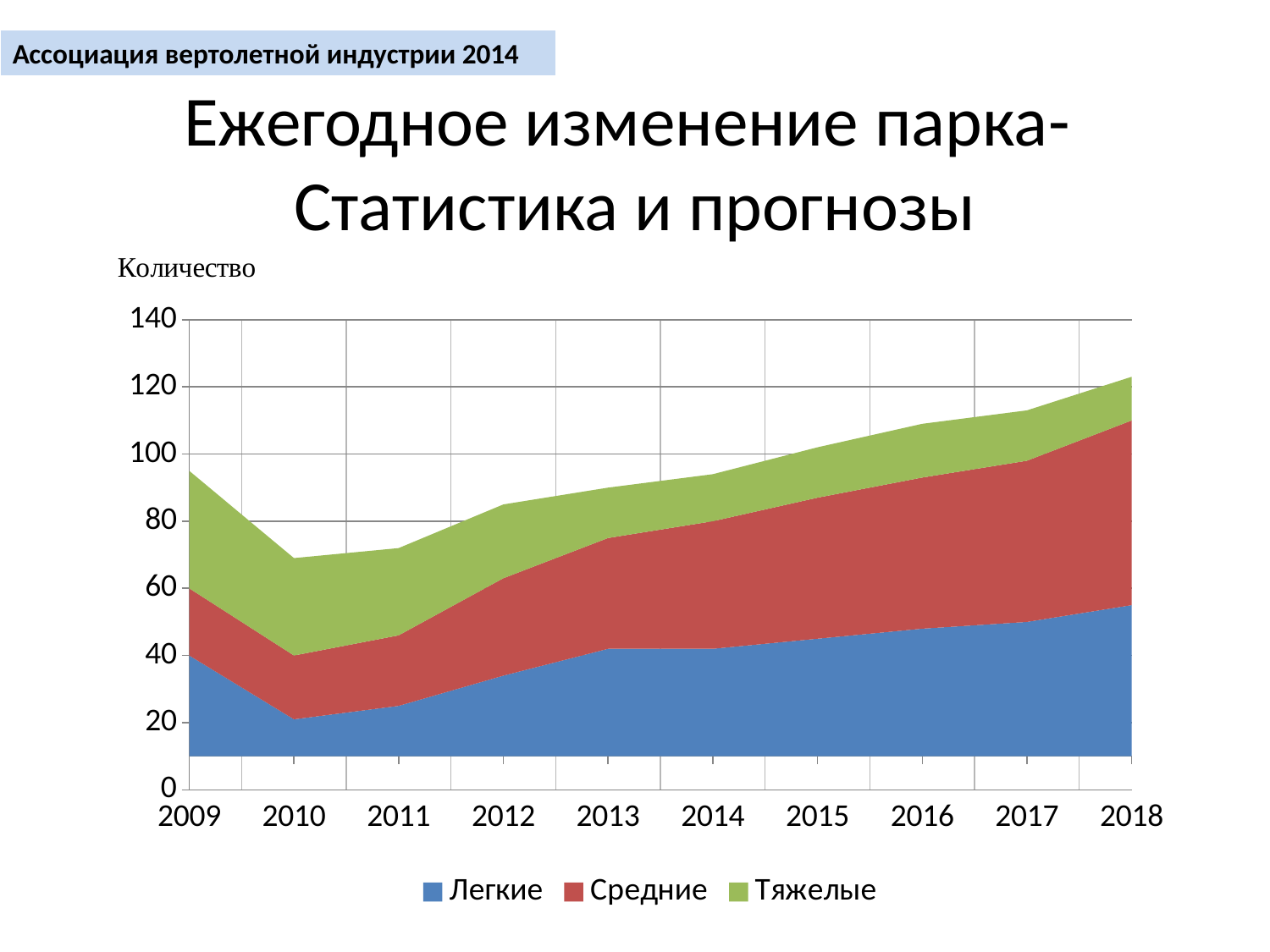
Is the top of the Легкие area in 2018 greater or less than 40? greater In which year is the total stacked value the highest? 2018 Is the total stacked value for 2010 greater or less than 80? less What kind of chart is shown on the slide? Stacked area chart How many years are shown along the x axis? 10 In which year is the total stacked value the lowest? 2010 Is the total stacked value for 2016 greater or less than 100? greater What is the label above the vertical axis? Количество How many series does the legend list? 3 Which series are listed in the legend? Легкие, Средние, Тяжелые Does the total stacked value rise or fall from 2010 to 2018? rise